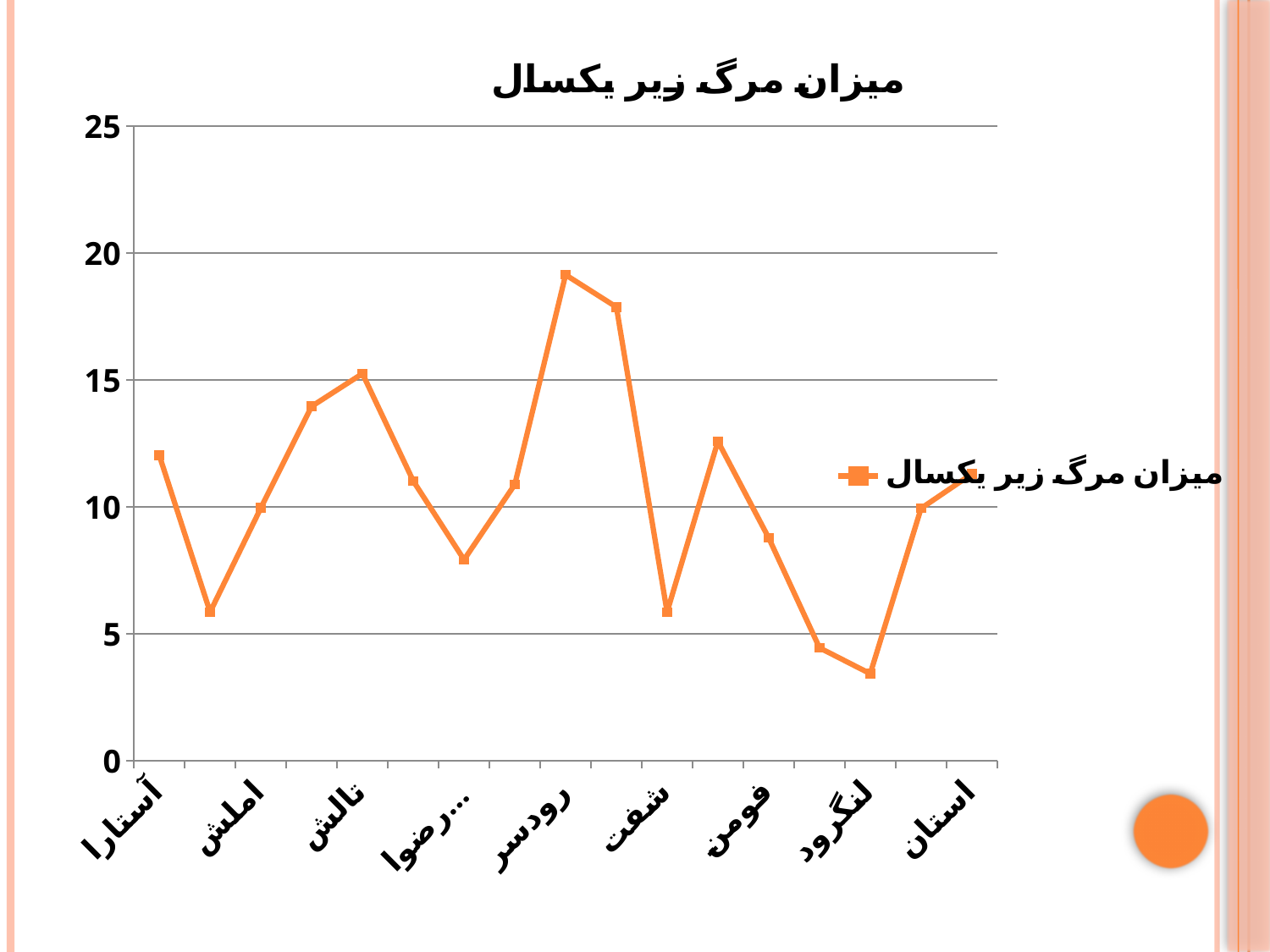
How many series does the legend list? 1 Is the value for رودسر greater or less than 15? greater Is the value for تالش greater or less than 10? greater Which labelled category has the lowest value? لنگرود What kind of chart is shown on the slide? line chart Which has the larger value, رودسر or شفت? رودسر Is the value for آستارا greater or less than 10? greater Which has the larger value, تالش or املش? تالش Which labelled category has the highest value? رودسر What is the title of the chart? میزان مرگ زیر یکسال